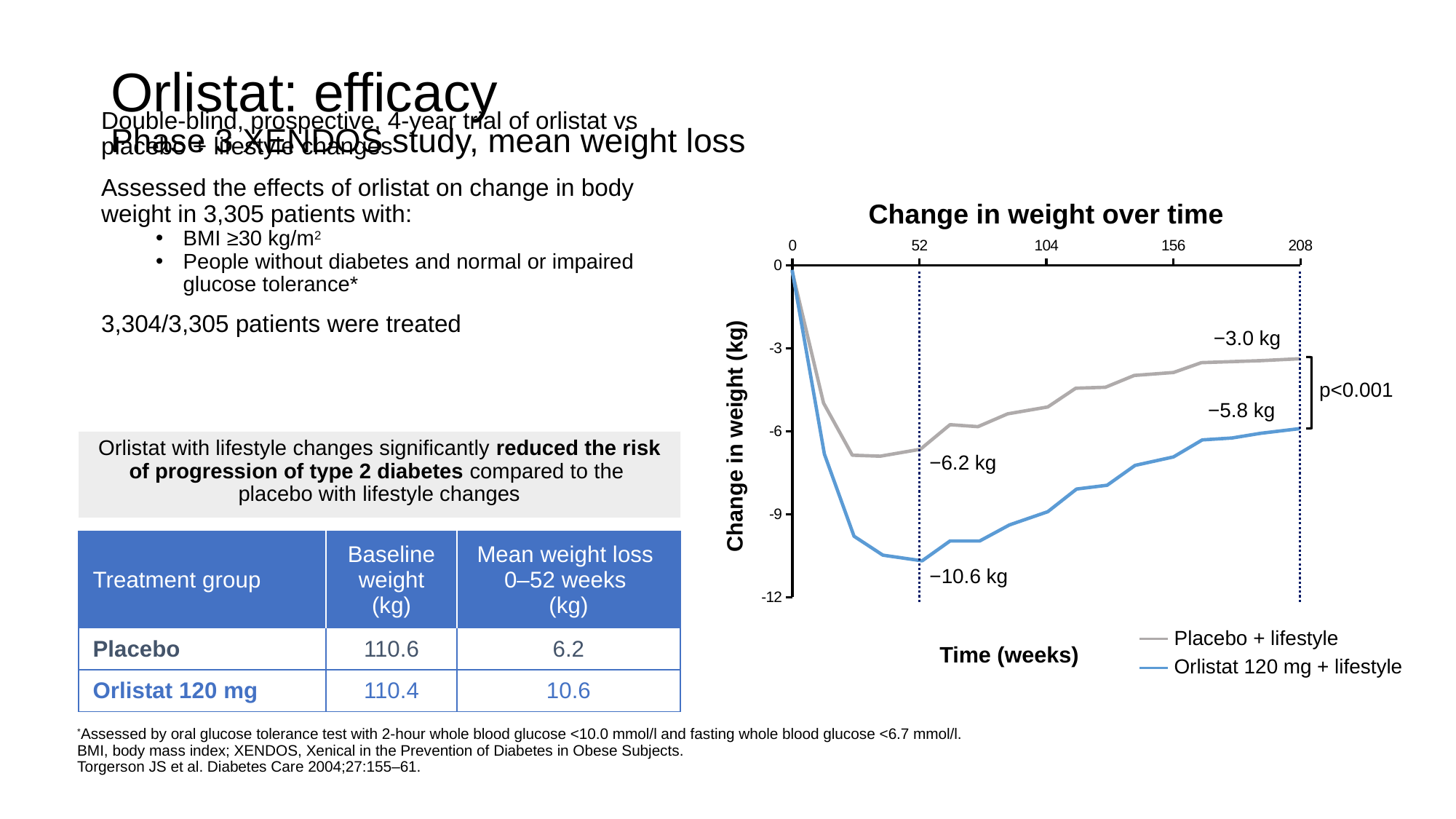
What is the title of the chart? Change in weight over time What is the difference between the Orlistat 120 mg + lifestyle and Placebo + lifestyle weight changes at week 52? 4.4 kg What is the labelled change in weight for Placebo + lifestyle at week 208? −3.0 kg What is the labelled change in weight for Orlistat 120 mg + lifestyle at week 208? −5.8 kg Which series shows the greater weight loss at week 52, Placebo + lifestyle or Orlistat 120 mg + lifestyle? Orlistat 120 mg + lifestyle What is the difference between the Orlistat 120 mg + lifestyle and Placebo + lifestyle weight changes at week 208? 2.8 kg What is the labelled change in weight for Placebo + lifestyle at week 52? −6.2 kg Between week 52 and week 208, does the Placebo + lifestyle line rise or fall? Rise How many series does the chart legend list? 2 What p-value is shown next to the bracket at week 208? p<0.001 What is the labelled change in weight for Orlistat 120 mg + lifestyle at week 52? −10.6 kg What kind of chart is shown on the slide? Line chart